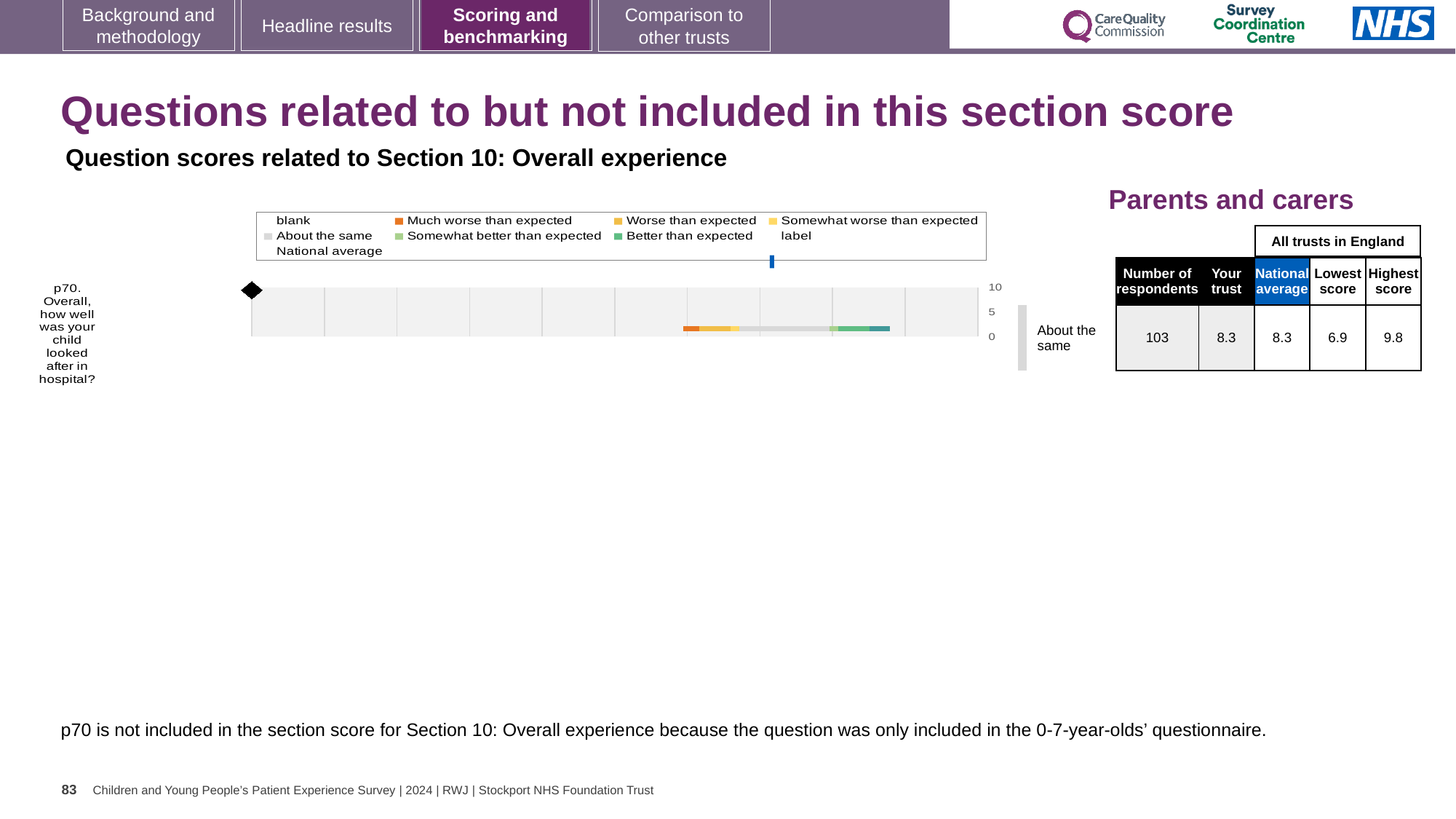
In the table next to the chart, what is the 'Your trust' score for p70? 8.3 In the table next to the chart, what is the highest score among all trusts in England for p70? 9.8 How many questions (categories) are plotted in the chart? 1 How many entries does the chart legend list? 9 In the table next to the chart, what is the national average score for p70? 8.3 What benchmark category label is shown to the right of the p70 bar? About the same What kind of chart is shown for question p70? bar chart In the table next to the chart, what is the number of respondents for p70? 103 In the table next to the chart, is the 'Your trust' score for p70 higher than, lower than, or equal to the national average? equal In the table next to the chart, what is the lowest score among all trusts in England for p70? 6.9 In the table next to the chart, what is the difference between the highest score and the lowest score for p70? 2.9 Which question is plotted in the chart? p70. Overall, how well was your child looked after in hospital?